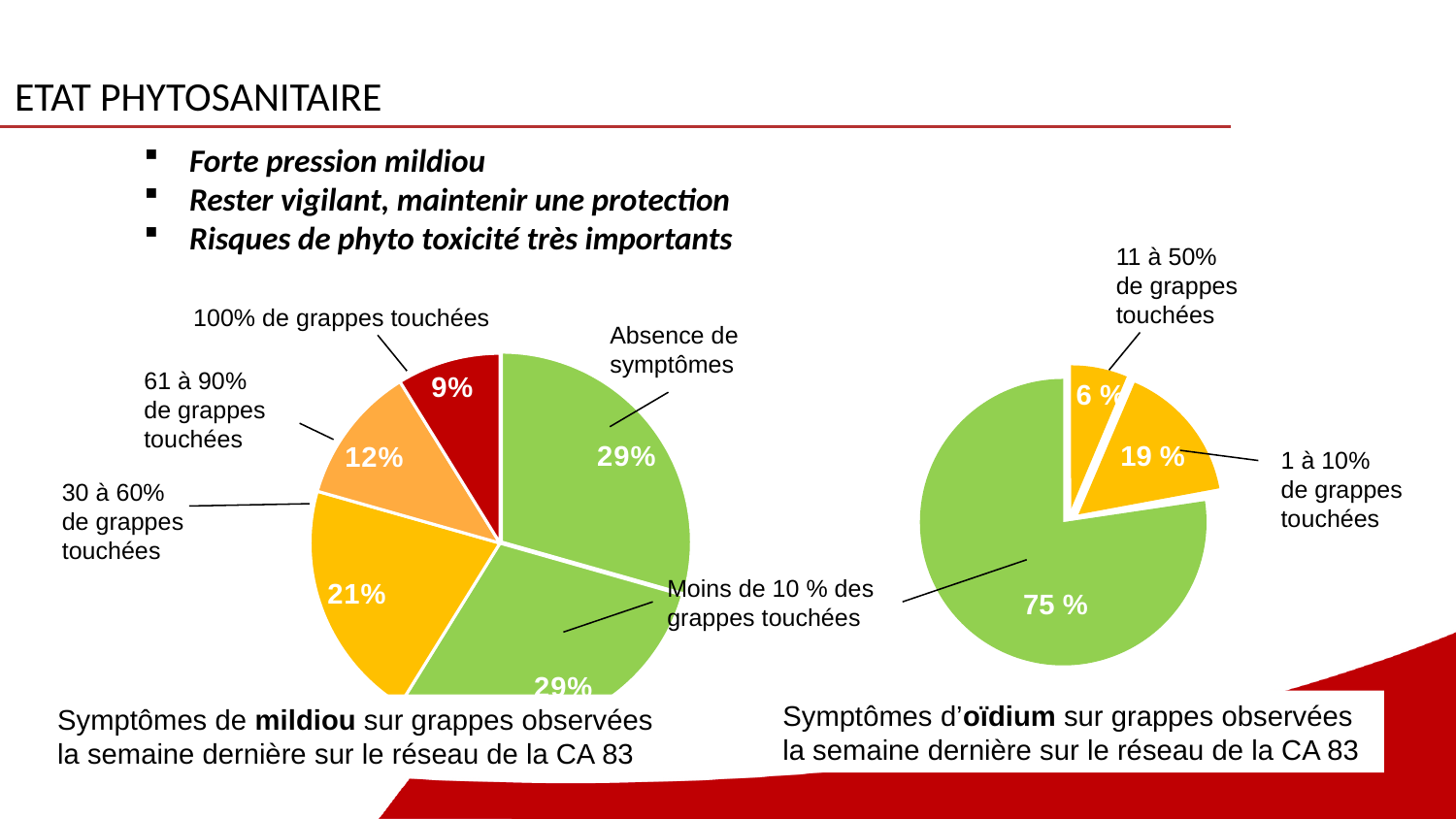
In the mildiou pie chart on the left, what share is labelled '61 à 90% de grappes touchées'? 12% In the mildiou pie chart on the left, what is the difference between the '30 à 60% de grappes touchées' share and the '61 à 90% de grappes touchées' share? 9% In the oïdium pie chart on the right, what is the value of the largest slice? 75 % In the mildiou pie chart on the left, how many slices are there? 5 What type of chart is used for the mildiou symptoms on the left of the slide? pie chart In the mildiou pie chart on the left, what share is labelled '30 à 60% de grappes touchées'? 21% In the mildiou pie chart on the left, what share is labelled 'Absence de symptômes'? 29% In the oïdium pie chart on the right, how many slices are there? 3 In the mildiou pie chart on the left, which category has the smallest share? 100% de grappes touchées In the mildiou pie chart on the left, what share is labelled '100% de grappes touchées'? 9% In the oïdium pie chart on the right, what share is labelled '11 à 50% de grappes touchées'? 6 % In the oïdium pie chart on the right, what share is labelled '1 à 10% de grappes touchées'? 19 %